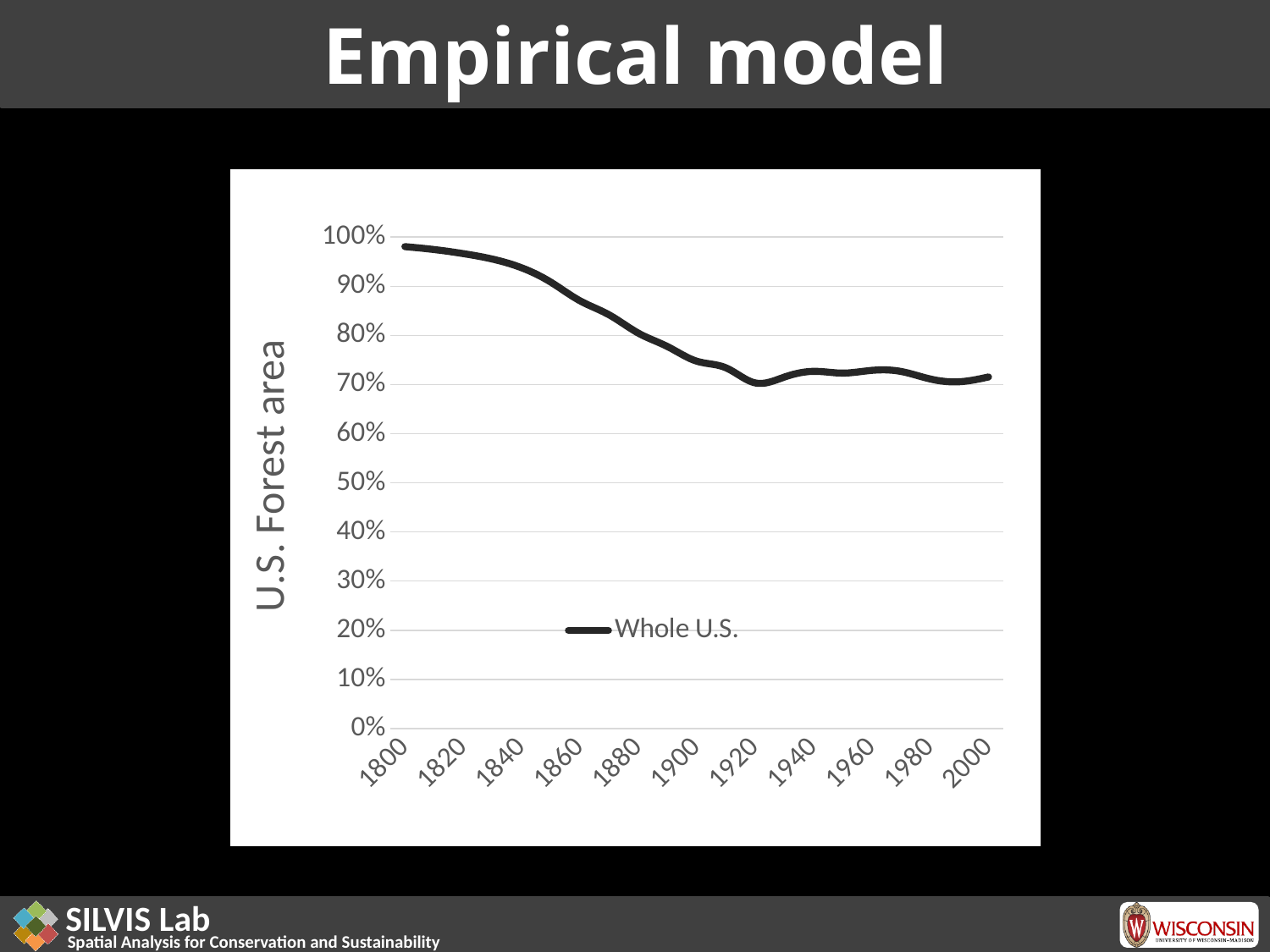
How many series does the chart's legend list? 1 Which year has the larger U.S. forest area value, 1800 or 2000? 1800 Is the value for 1800 greater or less than 90%? greater What is the title of the chart's vertical axis? U.S. Forest area Is the value for 1900 greater or less than 80%? less Is the value for 2000 greater or less than 80%? less In which year shown on the x axis is the U.S. forest area highest? 1800 What is the name of the series shown in the chart's legend? Whole U.S. What kind of chart is shown on the slide? line chart How many year labels are shown on the x axis? 11 Does the U.S. forest area value rise or fall overall from 1800 to 2000? fall